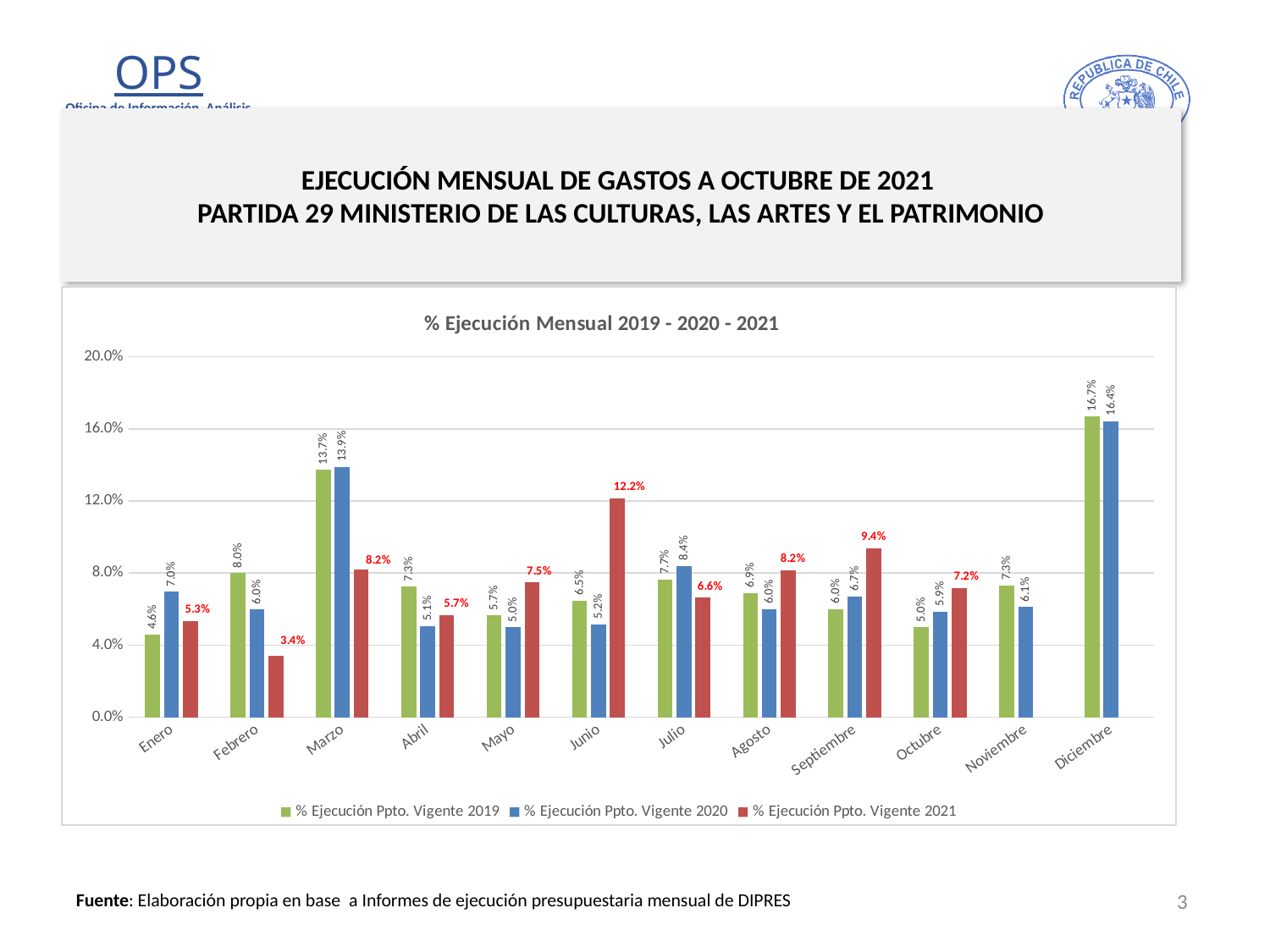
Which month has the highest value for % Ejecución Ppto. Vigente 2019? Diciembre What is the value for % Ejecución Ppto. Vigente 2019 in Diciembre? 16.7% How many months are shown on the x axis? 12 What is the value for % Ejecución Ppto. Vigente 2021 in Junio? 12.2% How many series does the legend list? 3 What is the difference between the 2021 and 2020 values in Junio? 7.0% What is the value for % Ejecución Ppto. Vigente 2020 in Marzo? 13.9% What kind of chart is shown on the slide? Bar chart Which month has the highest value for % Ejecución Ppto. Vigente 2021? Junio In Septiembre, which series is larger: % Ejecución Ppto. Vigente 2019 or % Ejecución Ppto. Vigente 2021? % Ejecución Ppto. Vigente 2021 What is the title of the chart? % Ejecución Mensual 2019 - 2020 - 2021 Which month has the lowest value for % Ejecución Ppto. Vigente 2021? Febrero